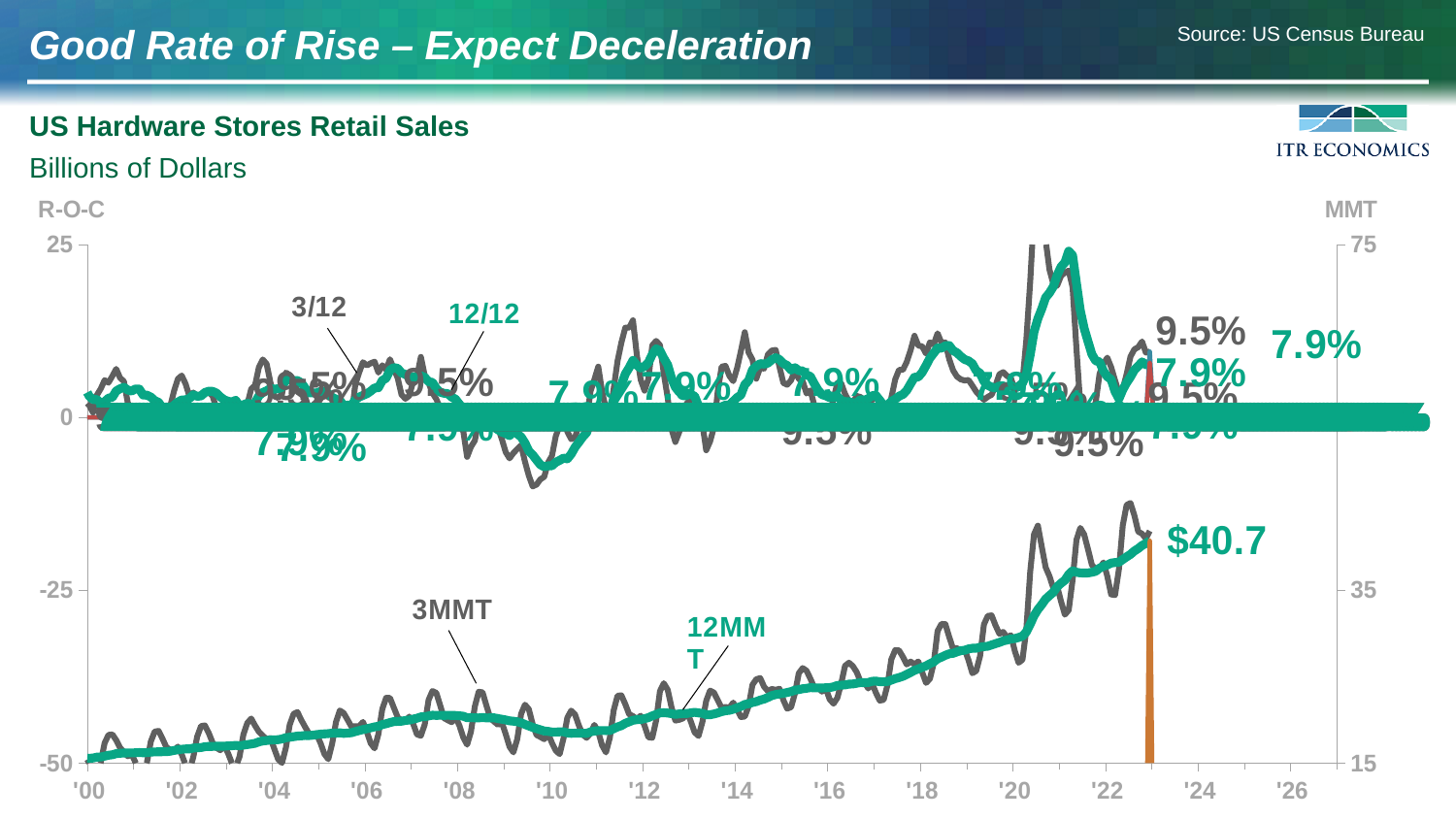
How many data series are labelled on the chart (3/12, 12/12, 3MMT, 12MMT)? 4 Is the 12MMT value around '10 greater or less than 35 on the MMT axis? less What is the latest 3/12 rate-of-change value labelled on the chart? 9.5% What is the highest value shown on the right-hand MMT axis? 75 Which is larger at the latest data point, the 3/12 rate of change or the 12/12 rate of change? 3/12 In what units are the retail sales values expressed? Billions of Dollars What is the title of the chart? US Hardware Stores Retail Sales What is the difference between the latest 3/12 value (9.5%) and the latest 12/12 value (7.9%)? 1.6 percentage points What is the latest 12MMT value labelled on the chart? $40.7 What kind of chart is shown on the slide? line chart What is the latest 12/12 rate-of-change value labelled on the chart? 7.9% Does the 12MMT line generally rise or fall from '00 to '22? rise